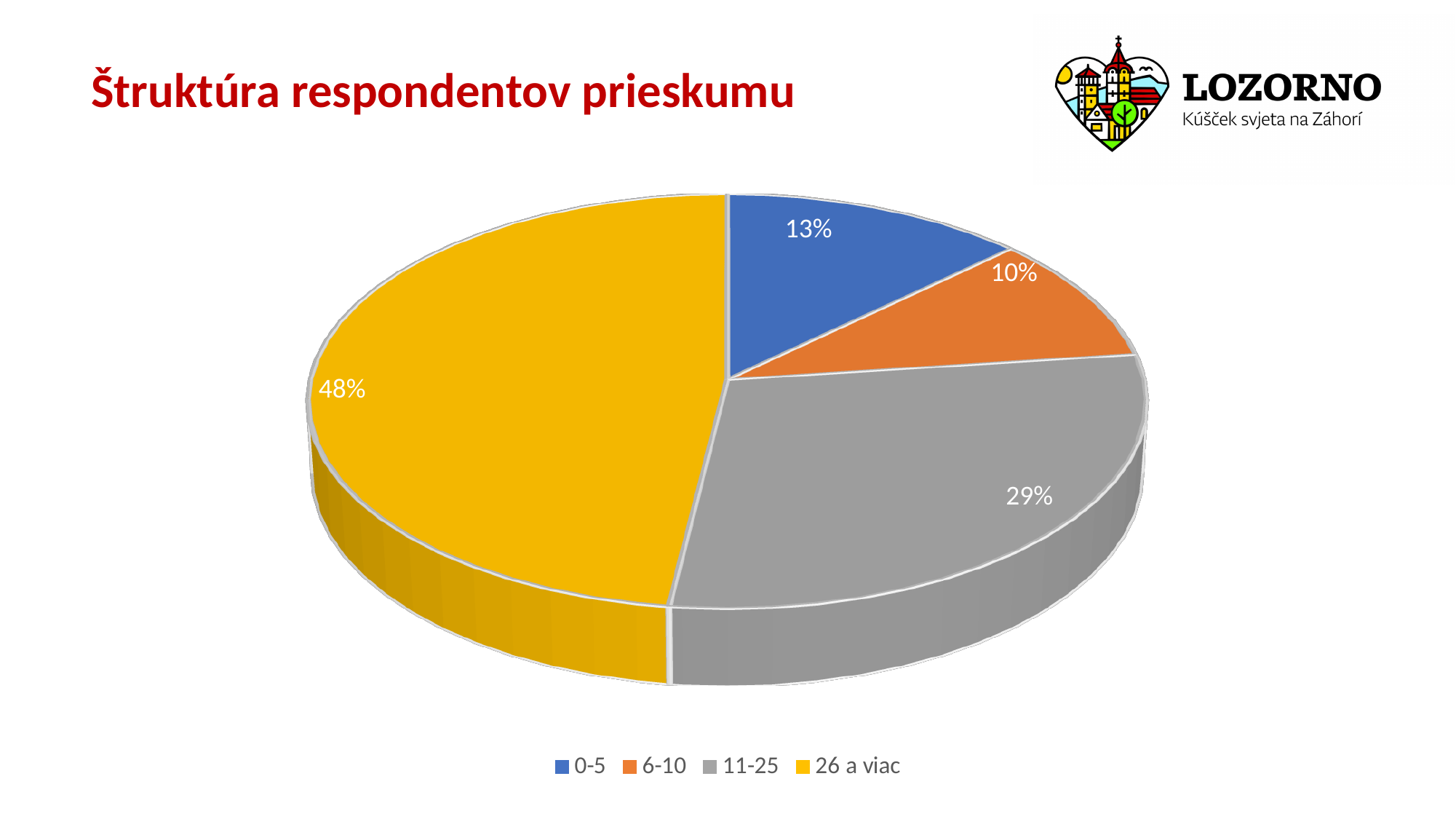
What is the value shown for the "6-10" category? 10% What is the value shown for the "0-5" category? 13% Which category has the smallest slice of the pie? 6-10 What kind of chart is shown on the slide? Pie chart Which category has the largest slice of the pie? 26 a viac What is the difference in percentage points between the "26 a viac" and "11-25" slices? 19 Which is larger, the "0-5" slice or the "6-10" slice? 0-5 What share of the pie does the "26 a viac" slice represent? 48% What colour is the "11-25" slice in the pie chart? Grey What is the value shown for the "11-25" category? 29% How many categories are shown in the pie chart? 4 What is the title of the slide containing the chart? Štruktúra respondentov prieskumu